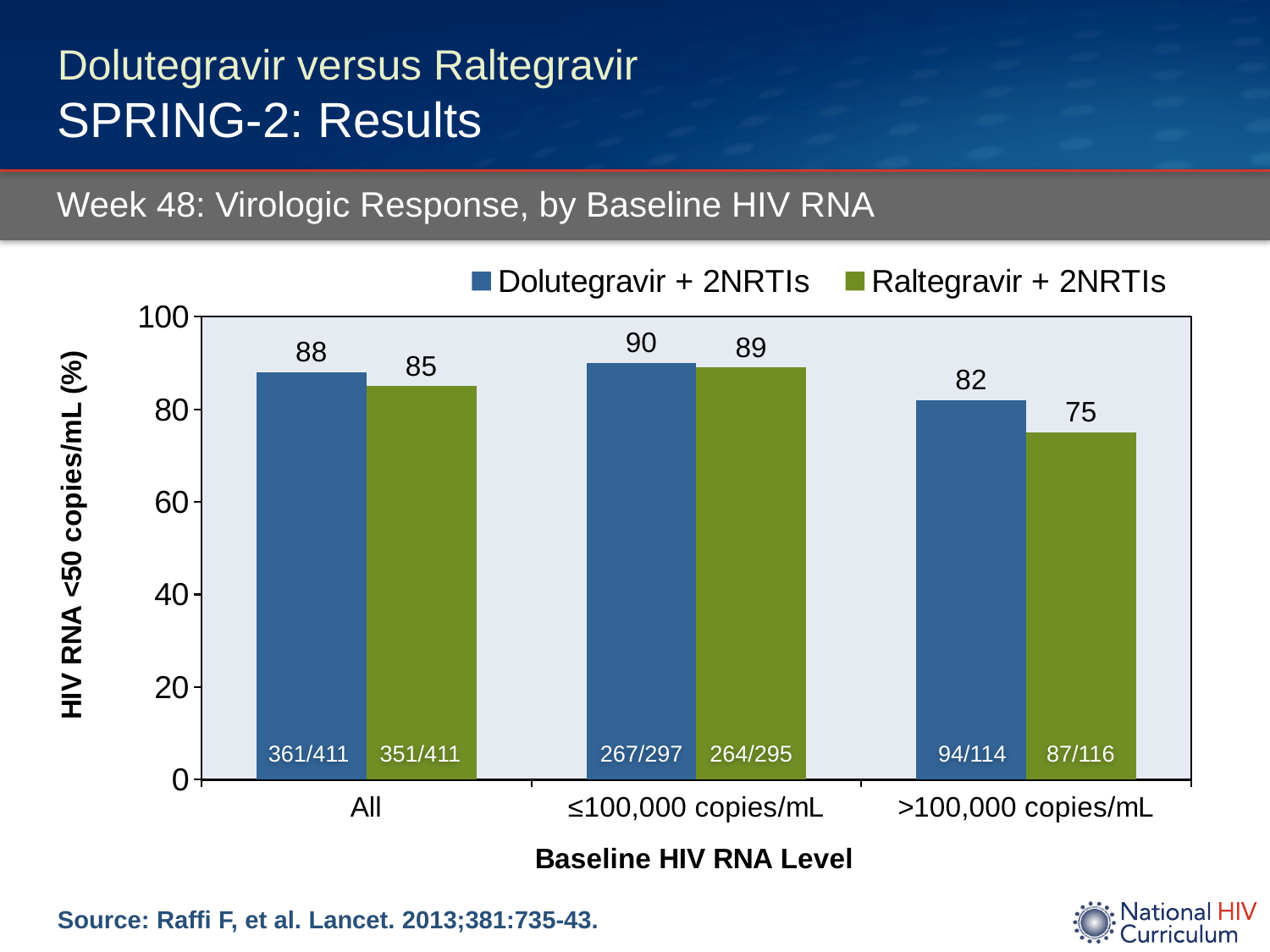
Which baseline HIV RNA category has the lowest value for Raltegravir + 2NRTIs? >100,000 copies/mL In the >100,000 copies/mL category, which series has the larger value, Dolutegravir + 2NRTIs or Raltegravir + 2NRTIs? Dolutegravir + 2NRTIs What is the difference between the Dolutegravir + 2NRTIs and Raltegravir + 2NRTIs values in the >100,000 copies/mL category? 7 What kind of chart is shown on the slide? Bar chart How many baseline HIV RNA categories are shown on the x axis? 3 What is the value for Raltegravir + 2NRTIs in the >100,000 copies/mL category? 75 Which baseline HIV RNA category has the highest value for Dolutegravir + 2NRTIs? ≤100,000 copies/mL How many series does the legend list? 2 What is the value for Raltegravir + 2NRTIs in the ≤100,000 copies/mL category? 89 What fraction is printed inside the Dolutegravir + 2NRTIs bar for the >100,000 copies/mL category? 94/114 What is the difference between the Dolutegravir + 2NRTIs and Raltegravir + 2NRTIs values in the All category? 3 What is the value for Dolutegravir + 2NRTIs in the All category? 88